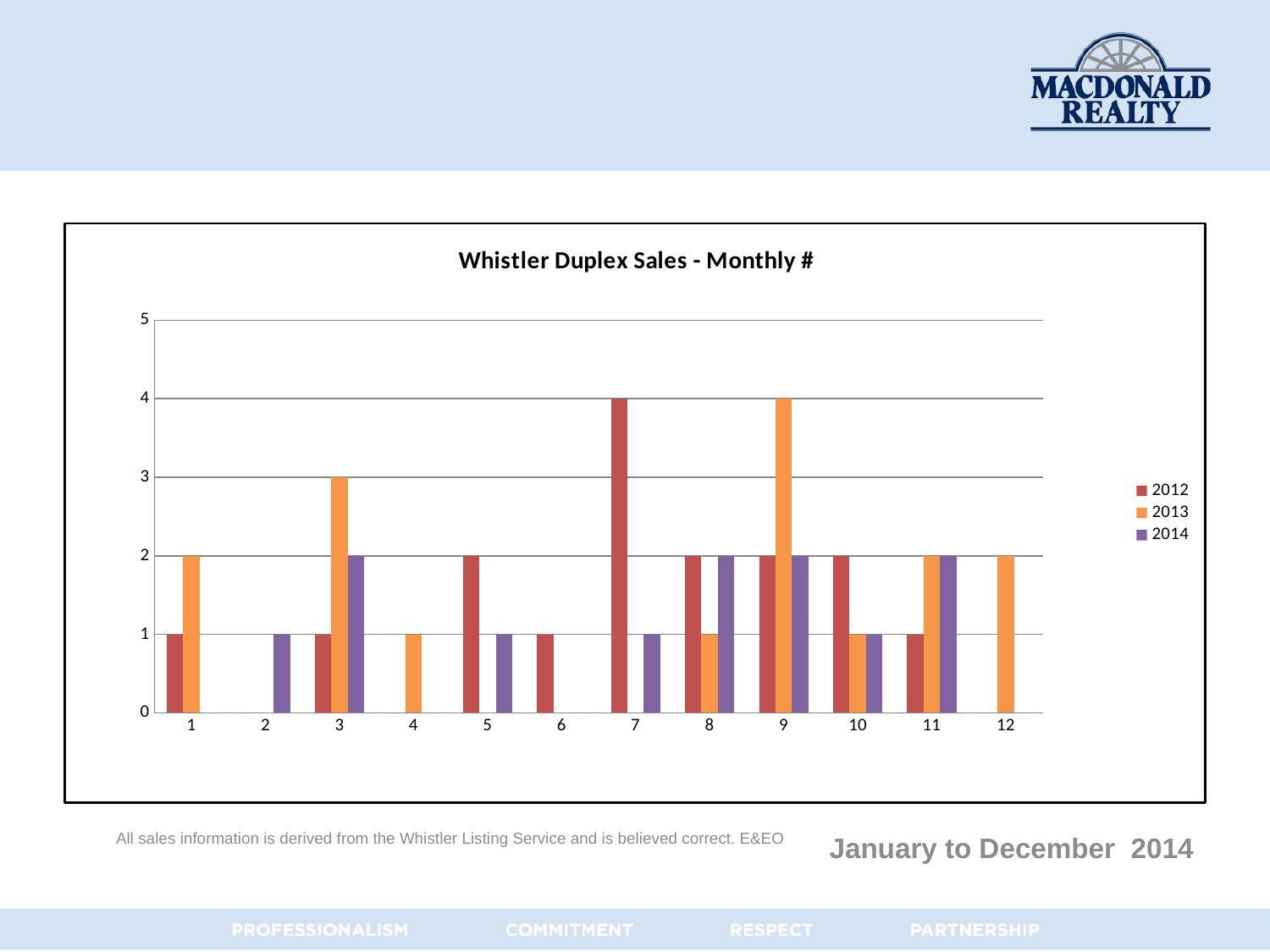
How many months are shown on the x axis? 12 What is the value for 2013 in month 3? 3 What is the value for 2012 in month 7? 4 How many series does the legend list? 3 What is the title of the chart? Whistler Duplex Sales - Monthly # In which month is the 2012 value highest? 7 What is the difference between the 2013 value and the 2012 value in month 3? 2 In which month is the 2013 value highest? 9 What type of chart is shown on the slide? Bar chart Which is larger in month 5, the 2012 value or the 2014 value? 2012 What is the value for 2014 in month 11? 2 What is the value for 2013 in month 9? 4